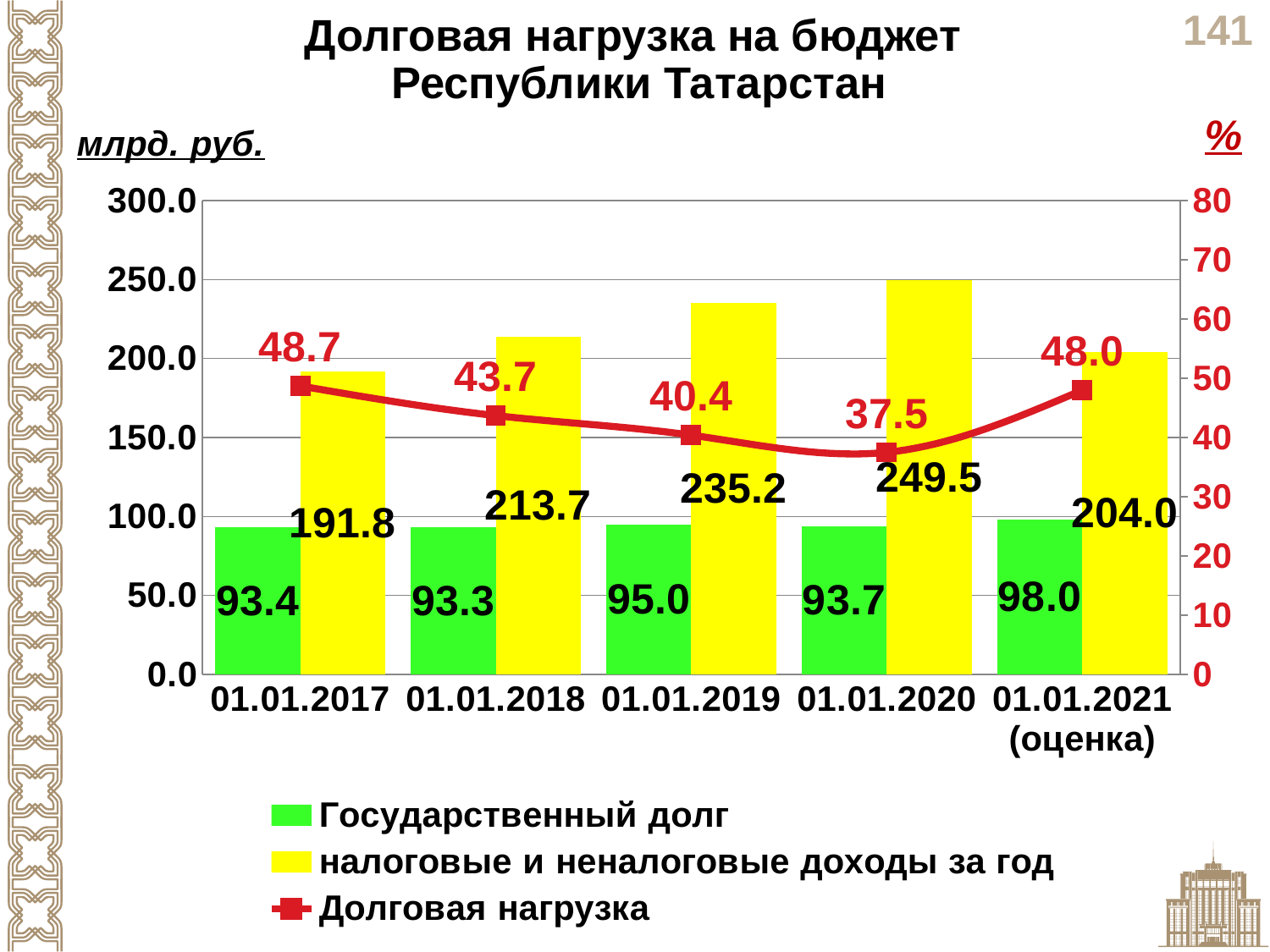
On which date is Долговая нагрузка the lowest? 01.01.2020 On which date is налоговые и неналоговые доходы за год the highest? 01.01.2020 Does Долговая нагрузка rise or fall from 01.01.2017 to 01.01.2020? Fall What is the Долговая нагрузка value on 01.01.2018? 43.7 What is the difference between налоговые и неналоговые доходы за год on 01.01.2020 and on 01.01.2021 (оценка)? 45.5 What colour are the bars for Государственный долг? Green Which is larger: Государственный долг on 01.01.2017 or on 01.01.2021 (оценка)? 01.01.2021 (оценка) How many dates are shown on the x axis? 5 What is the value of налоговые и неналоговые доходы за год on 01.01.2020? 249.5 What is the value of Государственный долг on 01.01.2019? 95.0 What kind of chart is this? Combined bar and line chart How many series does the legend list? 3